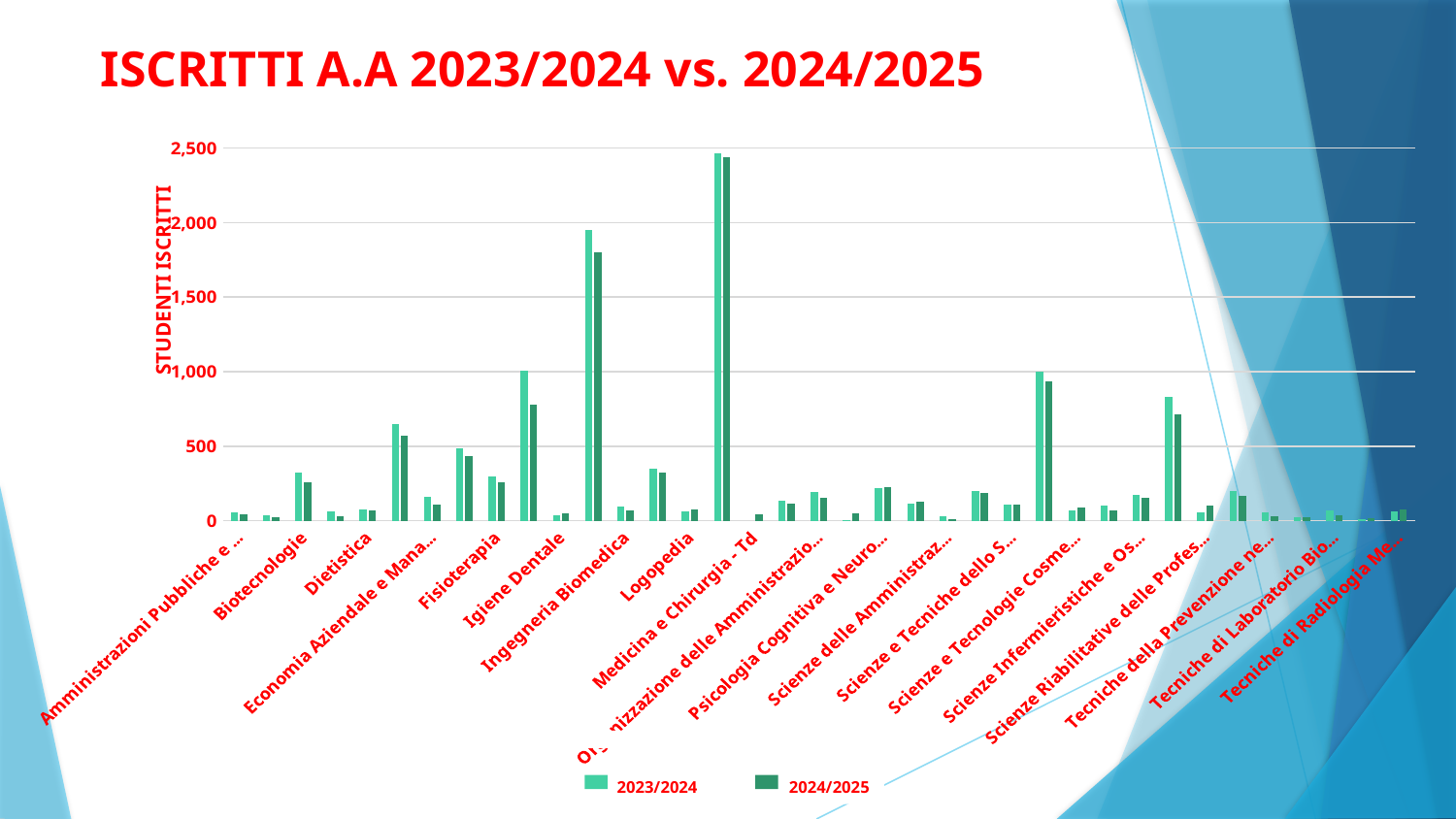
What is the title of the vertical axis? STUDENTI ISCRITTI What kind of chart is shown on the slide? bar chart Is the tallest bar in the chart greater or less than 2,000? greater How many series does the legend list? 2 What are the two series named in the legend? 2023/2024 and 2024/2025